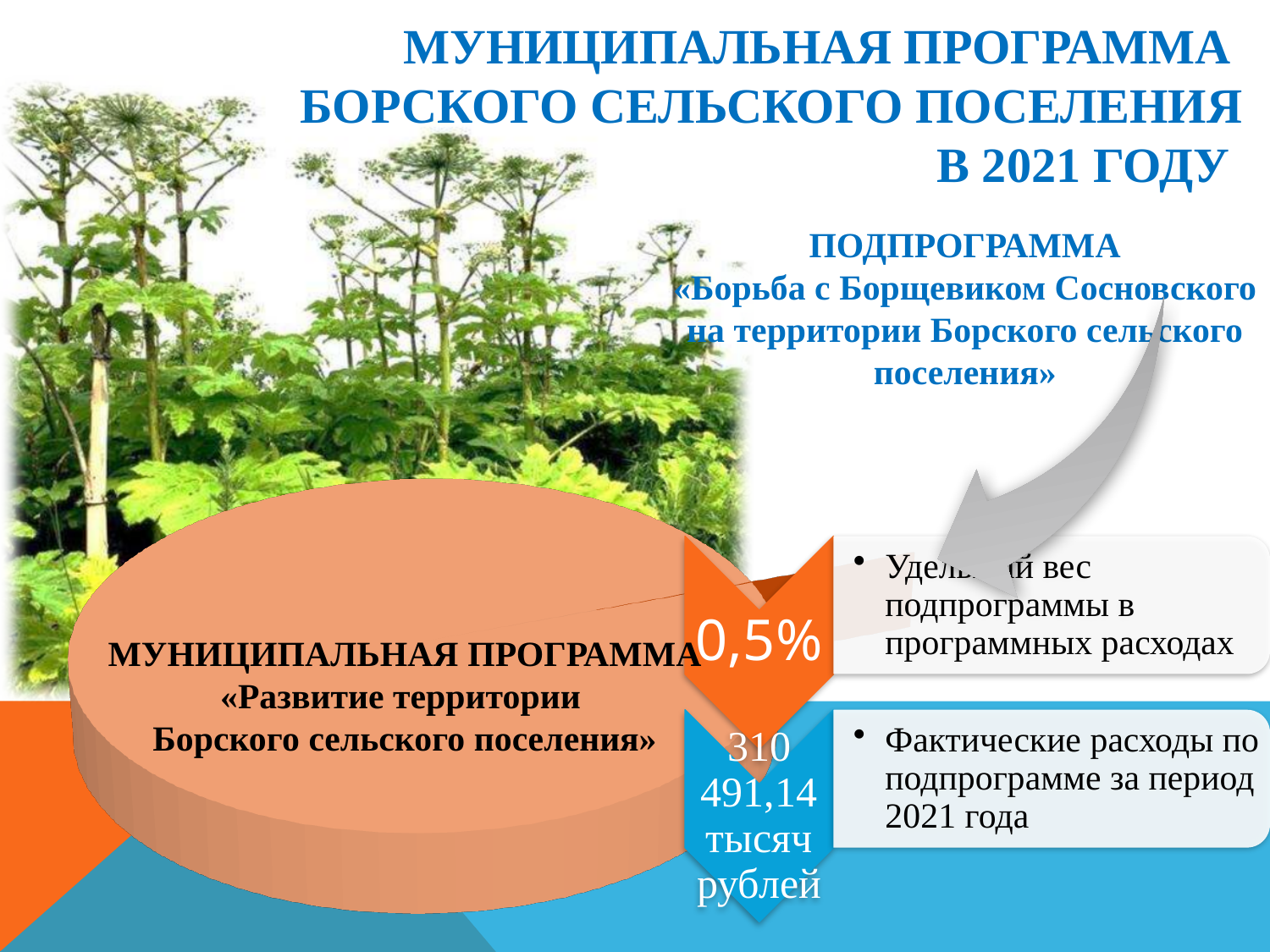
What share of the programme expenditure does the subprogramme «Борьба с Борщевиком Сосновского» account for, according to the slide? 0,5% Which municipal programme is named on the large slice of the pie chart? «Развитие территории Борского сельского поселения» How many slices does the pie chart contain? 2 What colour is the small slice representing the subprogramme in the pie chart? orange Is the subprogramme's share of programme expenditure greater or less than 1%? less What kind of chart is shown on the slide? pie chart What are the actual expenditures on the subprogramme for 2021 shown on the slide? 310 491,14 тысяч рублей Which is larger in the pie chart: the slice for the municipal programme «Развитие территории Борского сельского поселения» or the slice for the subprogramme «Борьба с Борщевиком Сосновского»? the municipal programme «Развитие территории Борского сельского поселения»